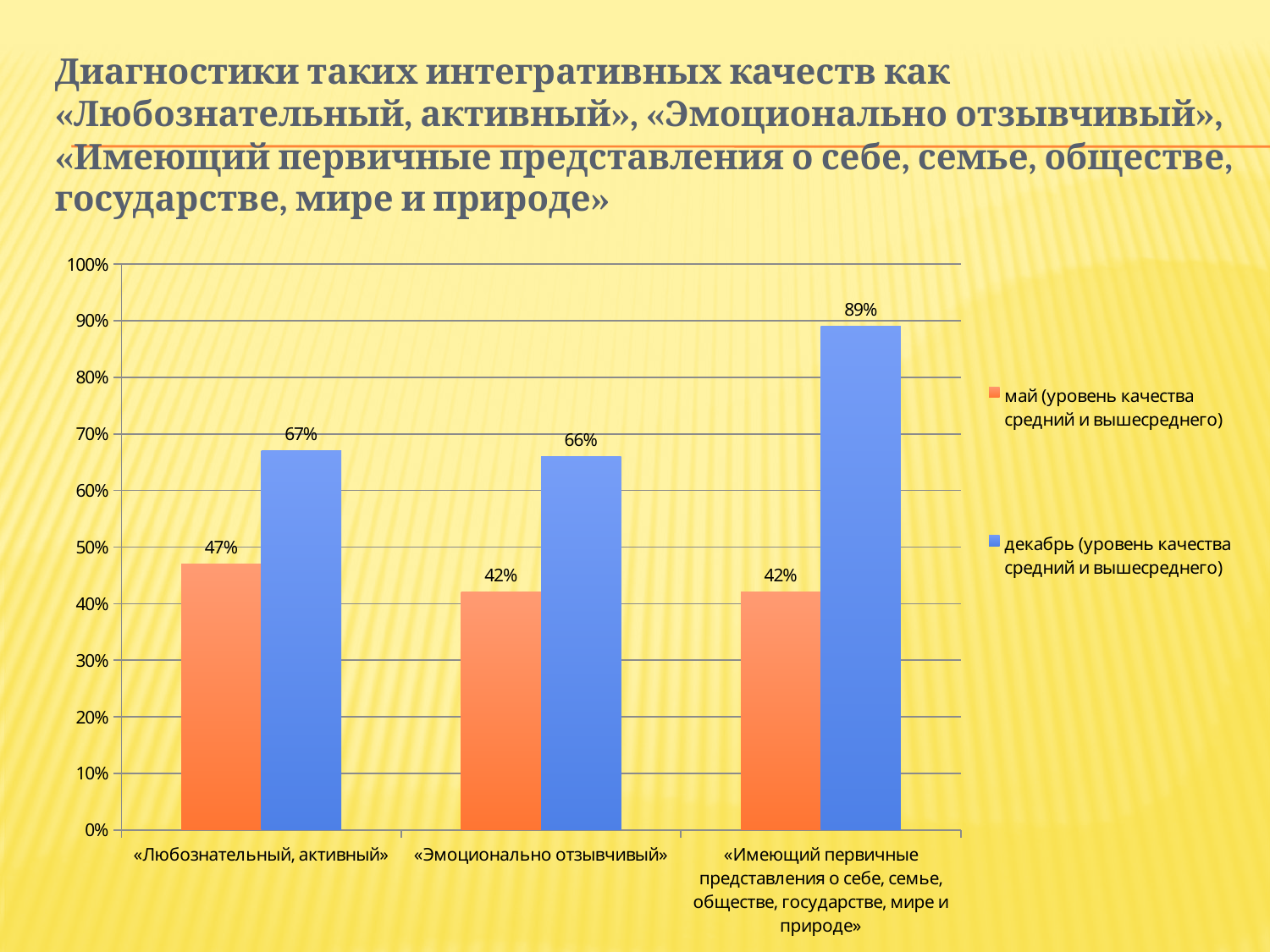
What colour are the bars for the май (уровень качества средний и вышесреднего) series? orange How many categories are shown on the x axis? 3 Which category has the highest value in the май series? «Любознательный, активный» What is the difference between the декабрь and май values for «Любознательный, активный»? 20% What kind of chart is shown on the slide? bar chart What is the value for «Имеющий первичные представления о себе, семье, обществе, государстве, мире и природе» in the декабрь (уровень качества средний и вышесреднего) series? 89% What is the value for «Эмоционально отзывчивый» in the декабрь series? 66% Which category has the highest value in the декабрь series? «Имеющий первичные представления о себе, семье, обществе, государстве, мире и природе» How many series does the legend list? 2 What is the difference between the декабрь and май values for «Имеющий первичные представления о себе, семье, обществе, государстве, мире и природе»? 47% What is the value for «Любознательный, активный» in the май (уровень качества средний и вышесреднего) series? 47% Which is larger for «Эмоционально отзывчивый»: the май value or the декабрь value? декабрь